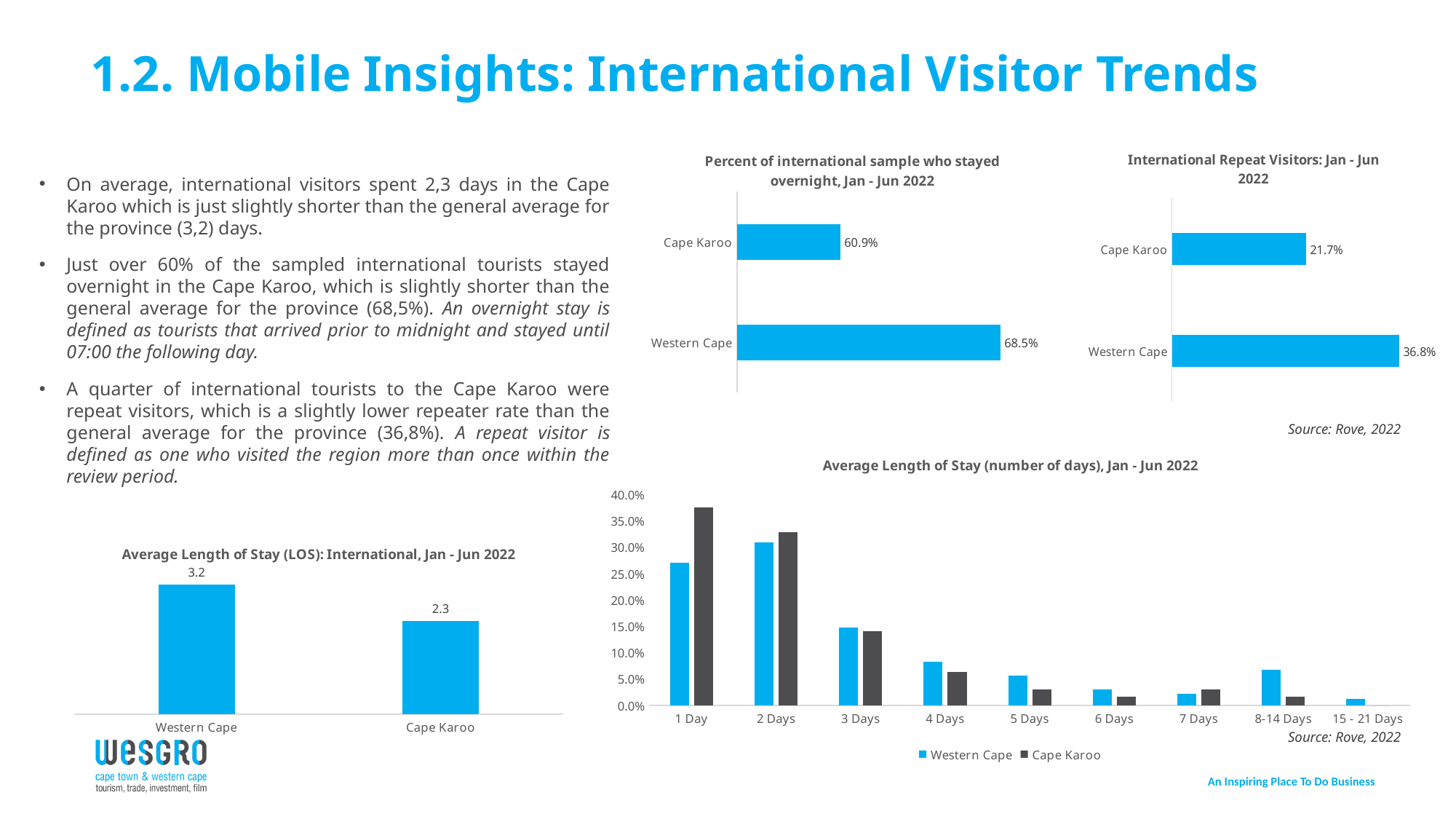
In the 'International Repeat Visitors' chart, which region has the lower value? Cape Karoo In the 'International Repeat Visitors' chart, what is the value for Western Cape? 36.8% What type of chart is the 'Average Length of Stay (number of days)' chart? Bar chart In the 'Average Length of Stay (LOS): International' chart, which region has the higher value? Western Cape In the 'Average Length of Stay (number of days)' chart, which series has the higher value for 4 Days? Western Cape How many categories are shown on the x axis of the 'Average Length of Stay (number of days)' chart? 9 In the 'International Repeat Visitors' chart, what is the difference between Western Cape and Cape Karoo? 15.1% In the 'Percent of international sample who stayed overnight' chart, what is the difference between Western Cape and Cape Karoo? 7.6% In the 'Percent of international sample who stayed overnight' chart, what is the value for Cape Karoo? 60.9% How many series does the legend of the 'Average Length of Stay (number of days)' chart list? 2 In the 'Average Length of Stay (number of days)' chart, is the Cape Karoo value for 1 Day greater or less than 35.0%? greater In the 'Average Length of Stay (LOS): International' chart, what is the value for Cape Karoo? 2.3